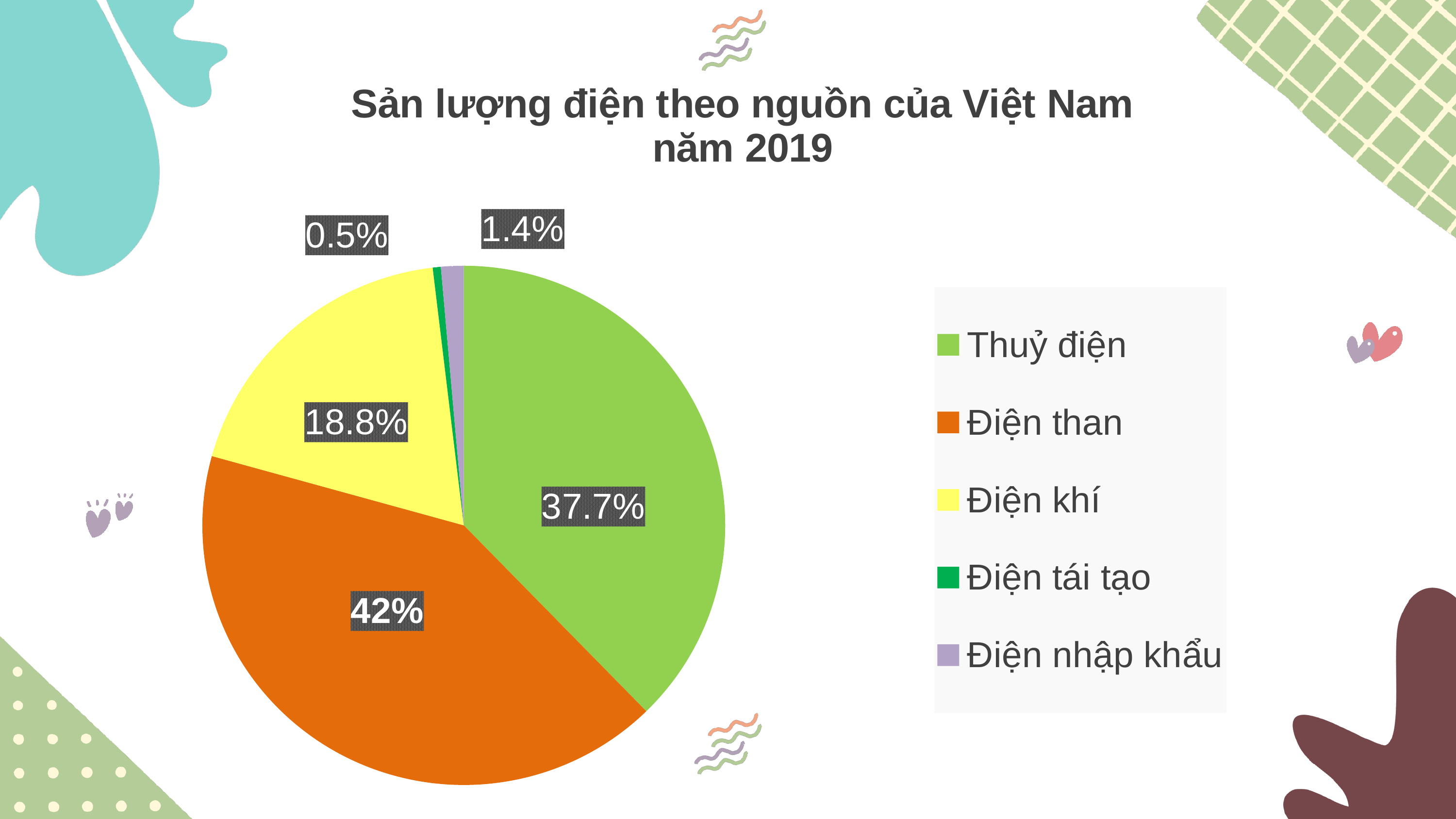
Which source has the largest share of the pie? Điện than What is the title of the chart? Sản lượng điện theo nguồn của Việt Nam năm 2019 Which is larger, the share for Điện khí or the share for Điện nhập khẩu? Điện khí What share of the pie does Điện khí have? 18.8% How many categories does the legend list? 5 What share of the pie does Điện nhập khẩu have? 1.4% What share of the pie does Điện than have? 42% Which source has the smallest share of the pie? Điện tái tạo What type of chart is shown on the slide? pie chart What is the difference in percentage points between Điện than and Thuỷ điện? 4.3 What share of the pie does Thuỷ điện have? 37.7% What share of the pie does Điện tái tạo have? 0.5%